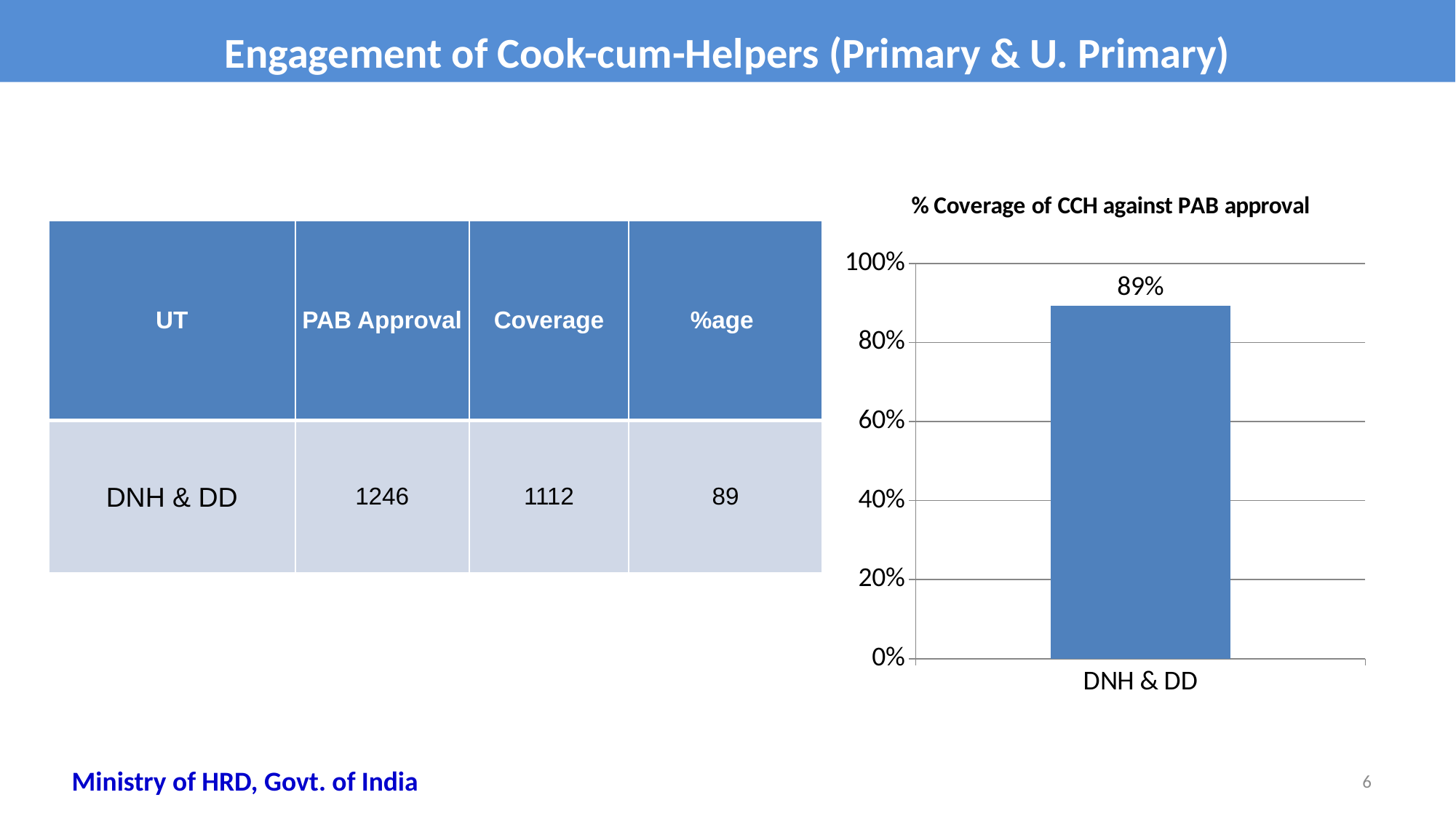
What is the value shown for DNH & DD in the chart? 89% How many categories are plotted in the chart? 1 What type of chart is shown on the slide? bar chart Is the value for DNH & DD greater or less than 80%? greater What is the title of the chart? % Coverage of CCH against PAB approval Is the value for DNH & DD greater or less than 100%? less What is the highest value shown on the chart's vertical axis? 100% Which category is labelled on the x axis of the chart? DNH & DD